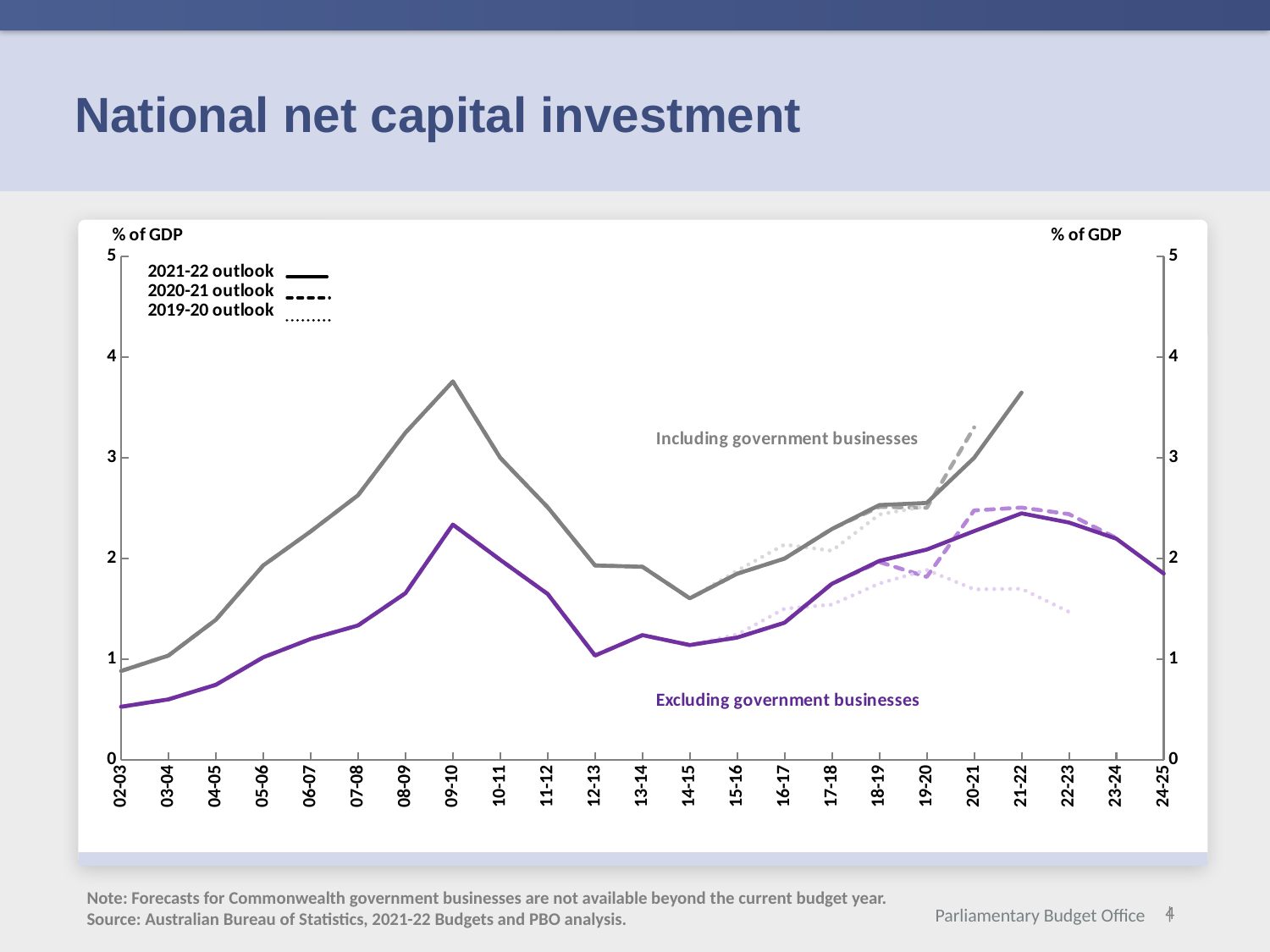
What kind of chart is shown on the slide? line chart Is the 2021-22 outlook value for 'Including government businesses' in 09-10 greater or less than 3% of GDP? greater Does the 'Including government businesses' line rise or fall between 09-10 and 14-15? fall Is the 'Including government businesses' value in 14-15 greater or less than 2% of GDP? less In which year is the 'Excluding government businesses' line at its lowest? 02-03 Is the 'Including government businesses' value in 02-03 greater or less than 1% of GDP? less What unit is shown on the y axis? % of GDP In 09-10, which line is higher: 'Including government businesses' or 'Excluding government businesses'? Including government businesses How many financial years are labelled along the x axis? 23 How many outlooks does the legend list? 3